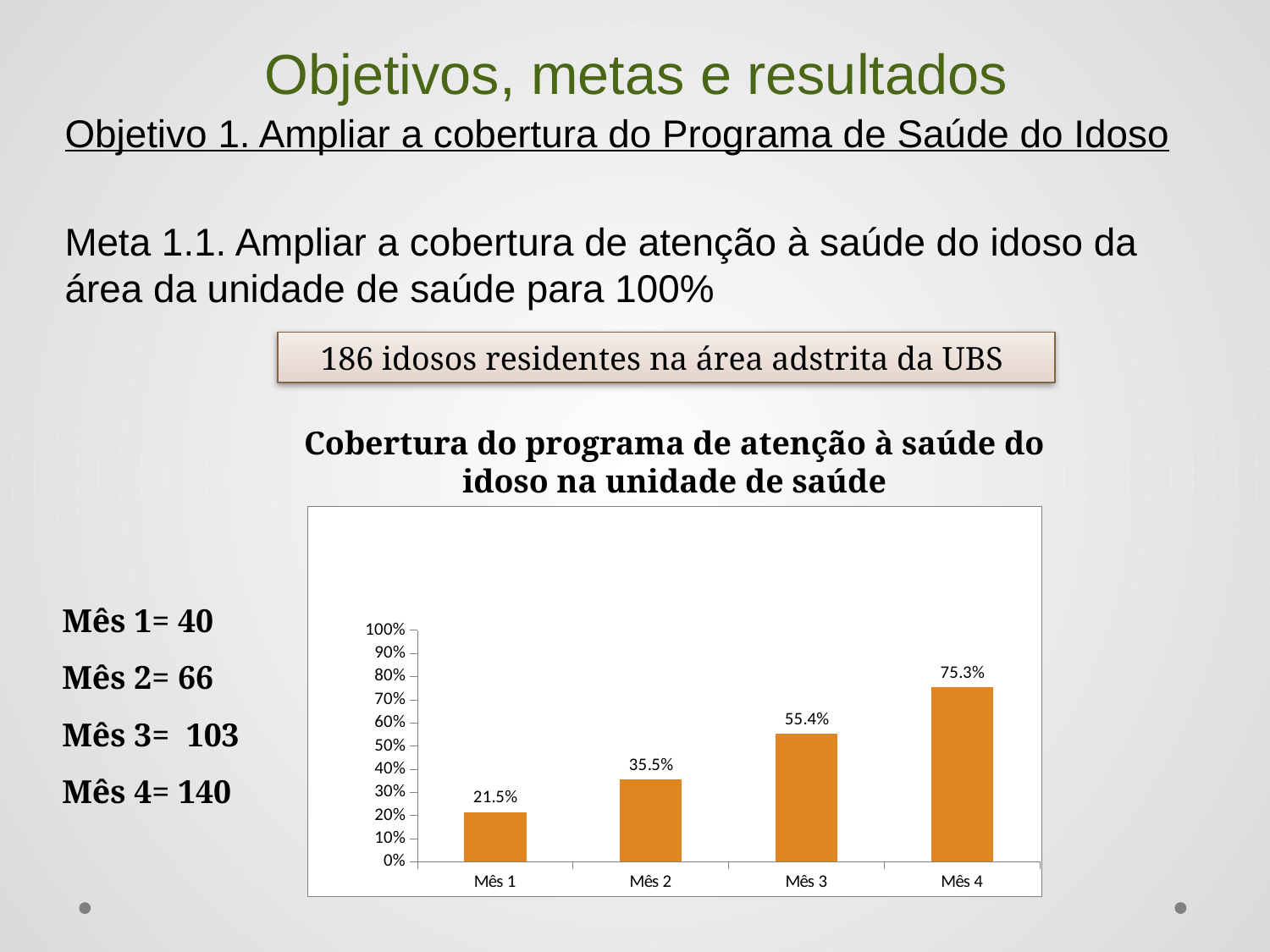
What kind of chart is shown? bar chart Is the value for Mês 4 greater or less than 70%? greater What is the difference between the values for Mês 4 and Mês 3? 19.9% Which is larger, the value for Mês 2 or the value for Mês 3? Mês 3 What is the value for Mês 1? 21.5% What is the difference between the values for Mês 2 and Mês 1? 14.0% Do the values rise or fall from Mês 1 to Mês 4? rise What is the value for Mês 4? 75.3% How many months are shown on the x axis? 4 What is the value for Mês 3? 55.4% Which month has the highest coverage? Mês 4 Which month has the lowest coverage? Mês 1